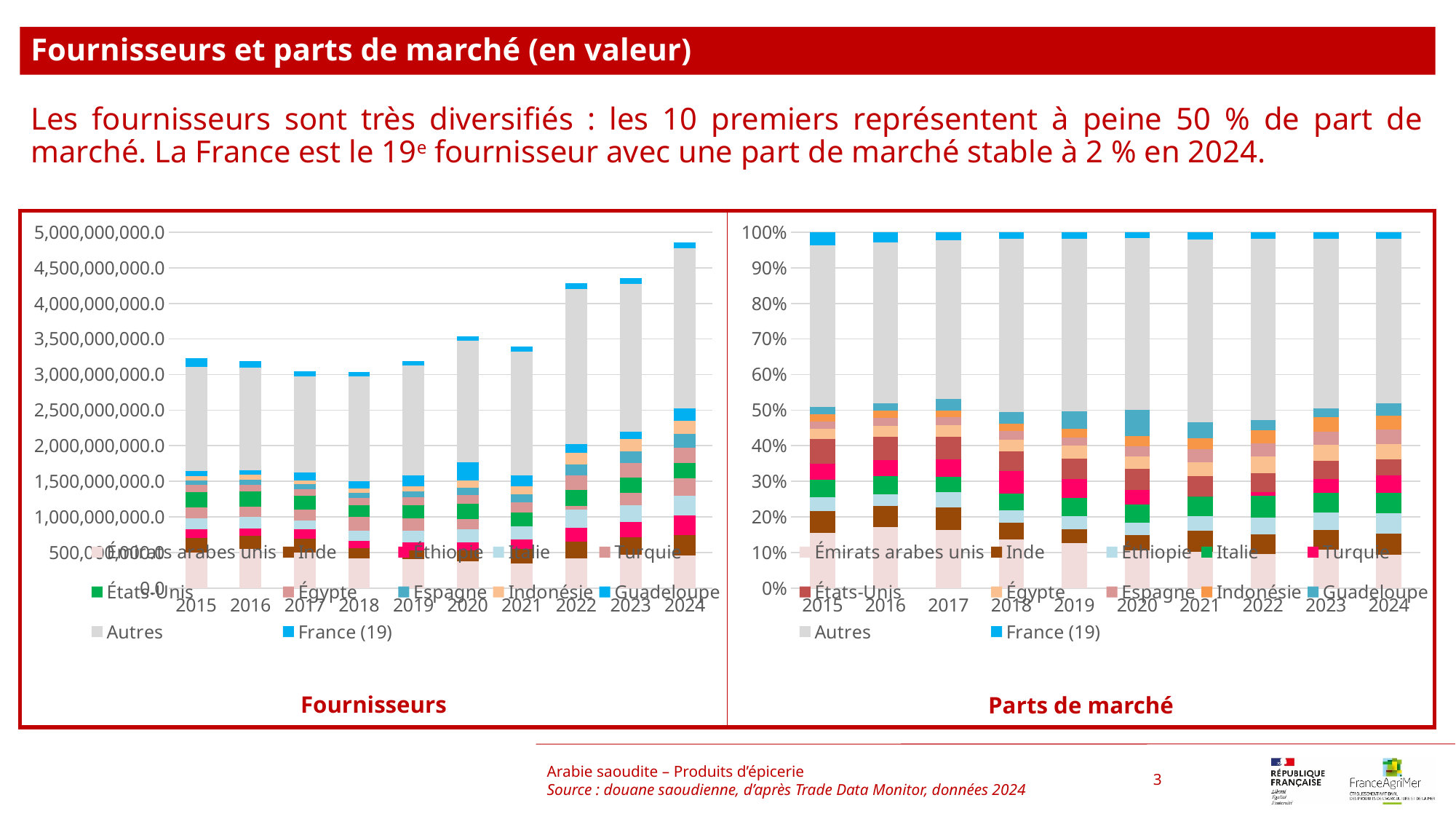
In the 'Fournisseurs' chart, do the total bars overall rise or fall from 2015 to 2024? rise How many series does the legend of the 'Parts de marché' chart list? 12 In the 'Parts de marché' chart, is the share of 'Autres' in 2024 greater or less than 40%? greater In the 'Fournisseurs' chart, is the total for 2015 greater or less than 3,500,000,000.0? less How many years are shown on the x axis of the 'Fournisseurs' chart? 10 In the 'Fournisseurs' chart, is the total for 2024 greater or less than 4,500,000,000.0? greater What is the title of the chart on the right of the slide? Parts de marché What kind of chart is the 'Fournisseurs' chart on the left? Stacked bar chart In the 'Fournisseurs' chart, which year has the larger total bar, 2019 or 2022? 2022 Which legend entry in the 'Fournisseurs' chart is shown in bright blue? France (19) In the 'Fournisseurs' chart, which year has the highest total bar? 2024